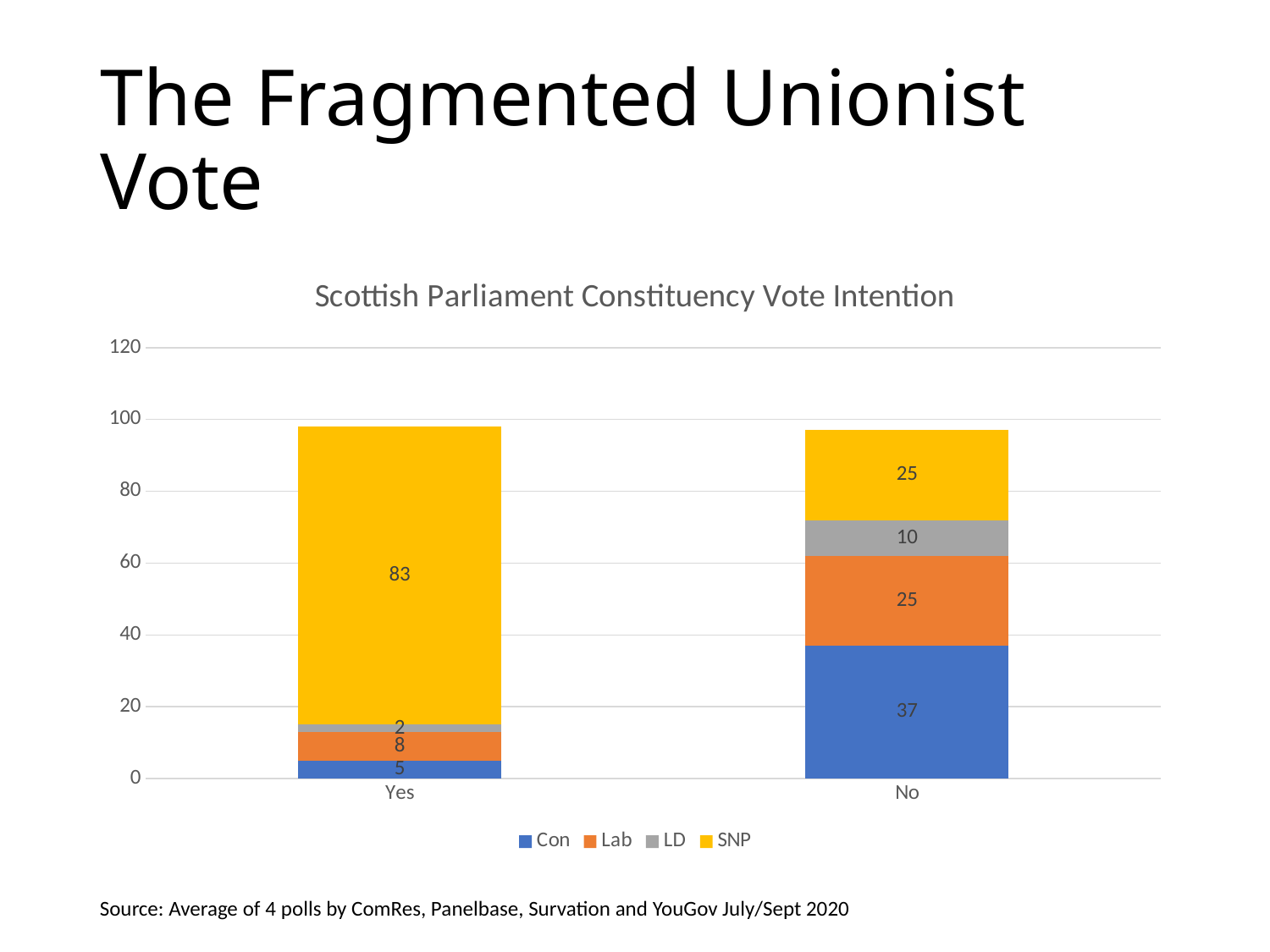
What is the Lab value for the Yes category? 8 What is the total of the stacked bar for the No category? 97 What is the difference between the SNP value for Yes and the SNP value for No? 58 How many series does the legend list? 4 What is the SNP value for the Yes category? 83 Which series has the highest value in the No category? Con Which is larger: the Lab value for No or the Con value for No? Con value for No How many categories are shown on the x axis? 2 Which series has the lowest value in the Yes category? LD What is the LD value for the No category? 10 What is the Con value for the No category? 37 What kind of chart is shown on the slide? Stacked bar chart